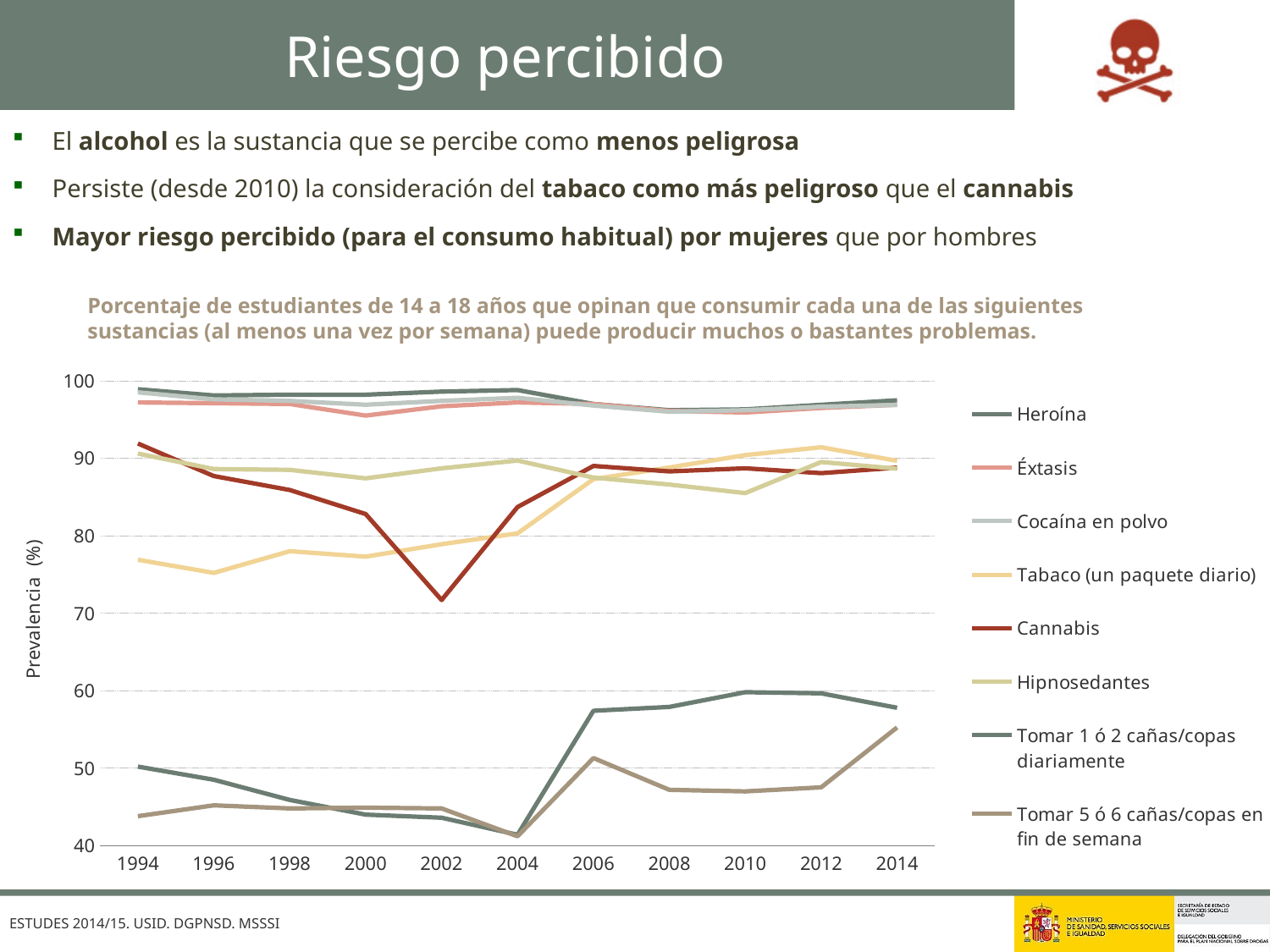
How many years are shown along the x axis of the chart? 11 How many series does the chart legend list? 8 What is the label on the y axis of the chart? Prevalencia (%) In 2002, which is larger: the value for Cannabis or the value for Tabaco (un paquete diario)? Tabaco (un paquete diario) Is the value for Tabaco (un paquete diario) in 1994 greater or less than 80? less Is the value for Cannabis in 2002 greater or less than 80? less Which series has the lowest value in 2014? Tomar 5 ó 6 cañas/copas en fin de semana Is the value for Heroína in 1994 greater or less than 90? greater What kind of chart is shown on the slide? line chart In 1994, which is larger: the value for Cannabis or the value for Tabaco (un paquete diario)? Cannabis Does the value for Cannabis rise or fall between 1994 and 2002? fall